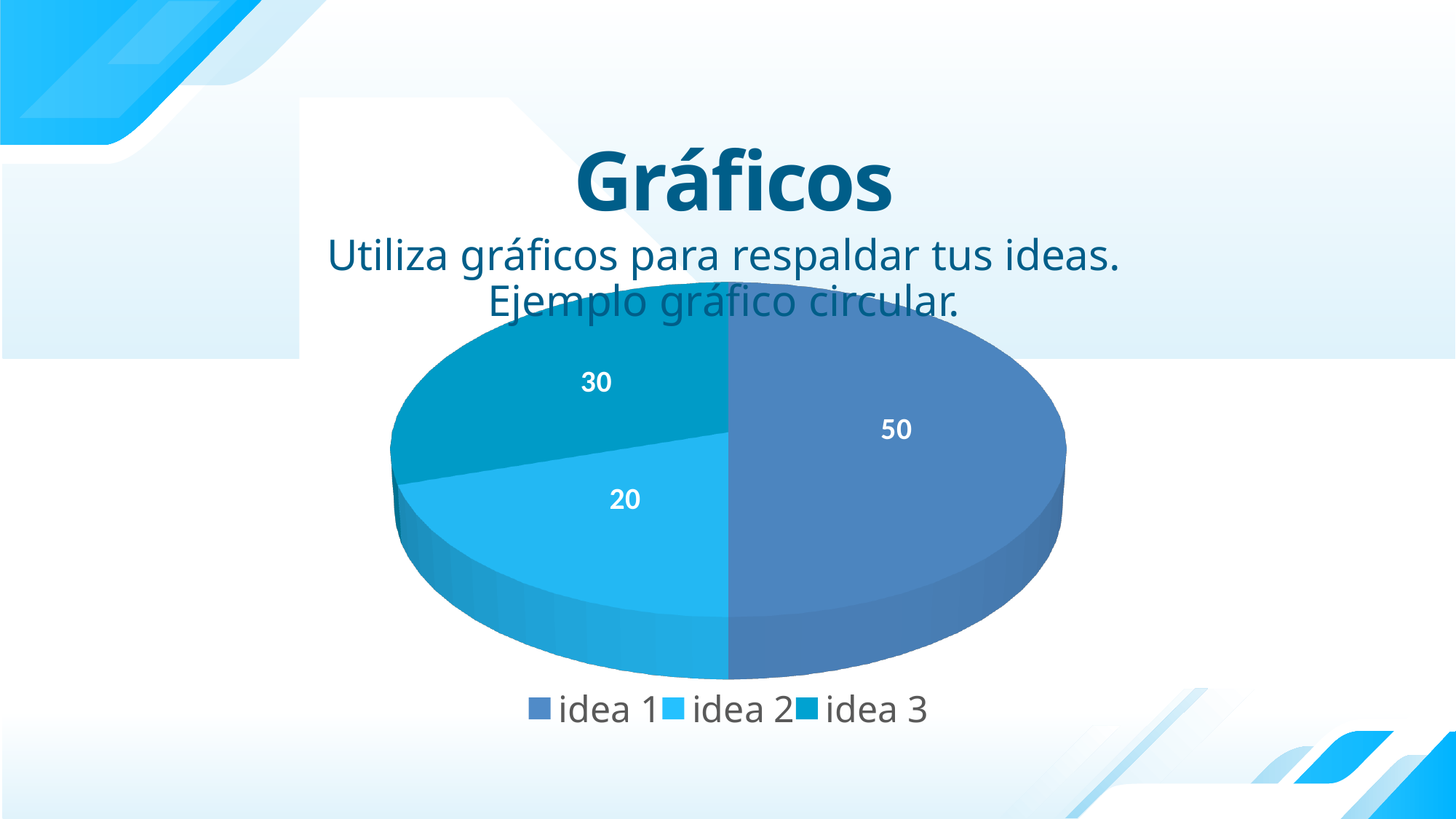
What is the value for idea 1? 50 What is the value for idea 3? 30 What kind of chart is shown on the slide? pie chart Which is larger, idea 2 or idea 3? idea 3 What is the value for idea 2? 20 What is the difference between the values for idea 3 and idea 2? 10 What is the difference between the values for idea 1 and idea 2? 30 How many slices does the pie chart have? 3 What share of the pie does idea 1 represent? 50% What is the title of the slide containing the chart? Gráficos Which category has the largest slice? idea 1 Which category has the smallest slice? idea 2